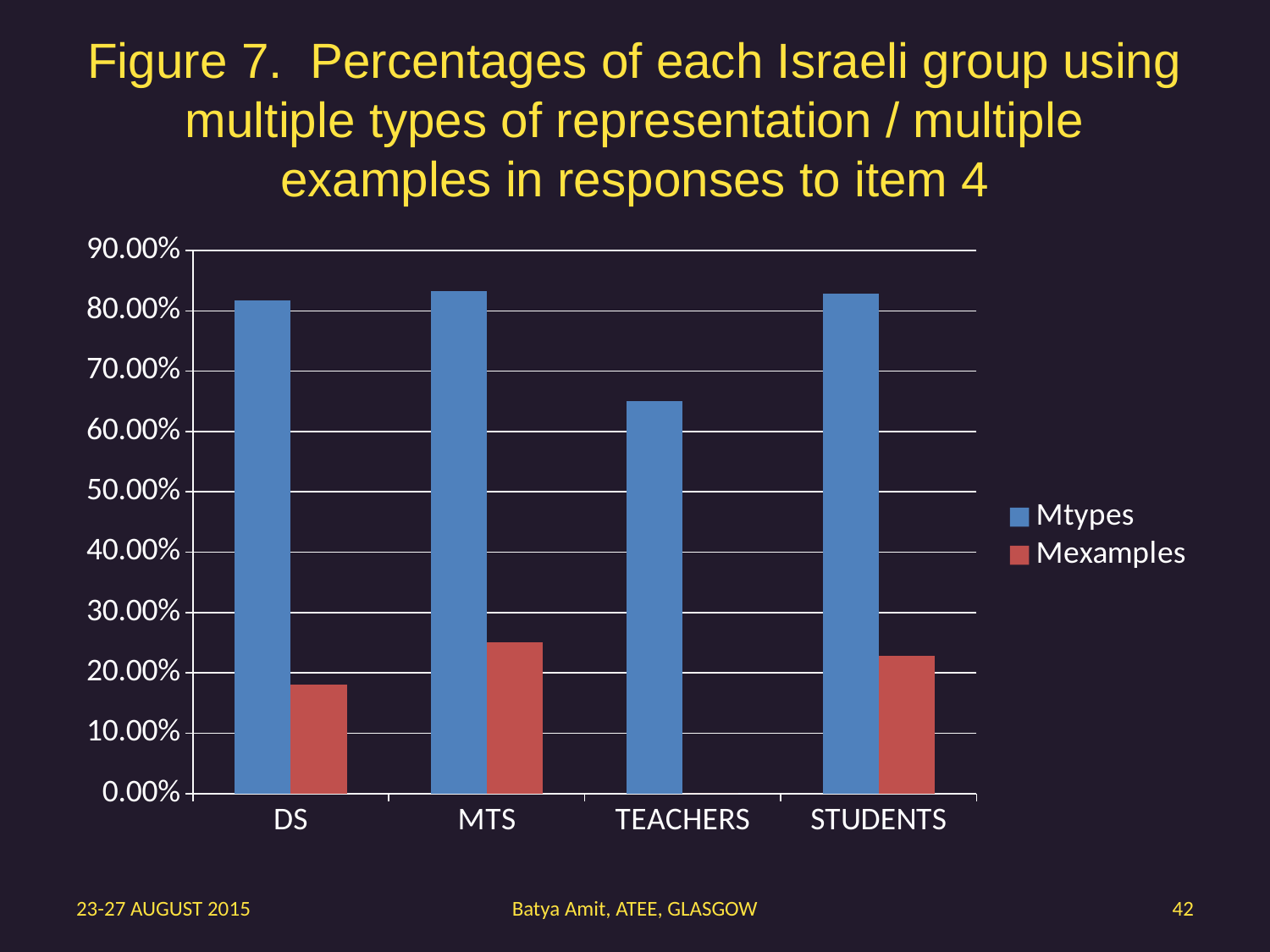
Is the Mexamples value for DS greater or less than 20.00%? less How many series does the chart legend list? 2 Is the Mtypes value for TEACHERS greater or less than 70.00%? less Which group has the larger Mexamples value, DS or MTS? MTS Which group has the highest Mexamples value? MTS How many groups are shown along the x axis of the chart? 4 What kind of chart is shown on the slide? bar chart Is the Mtypes value for MTS greater or less than 80.00%? greater Which colour represents the Mexamples series in the chart? red Which group has the lowest Mtypes value? TEACHERS Which is larger for DS: the Mtypes value or the Mexamples value? Mtypes